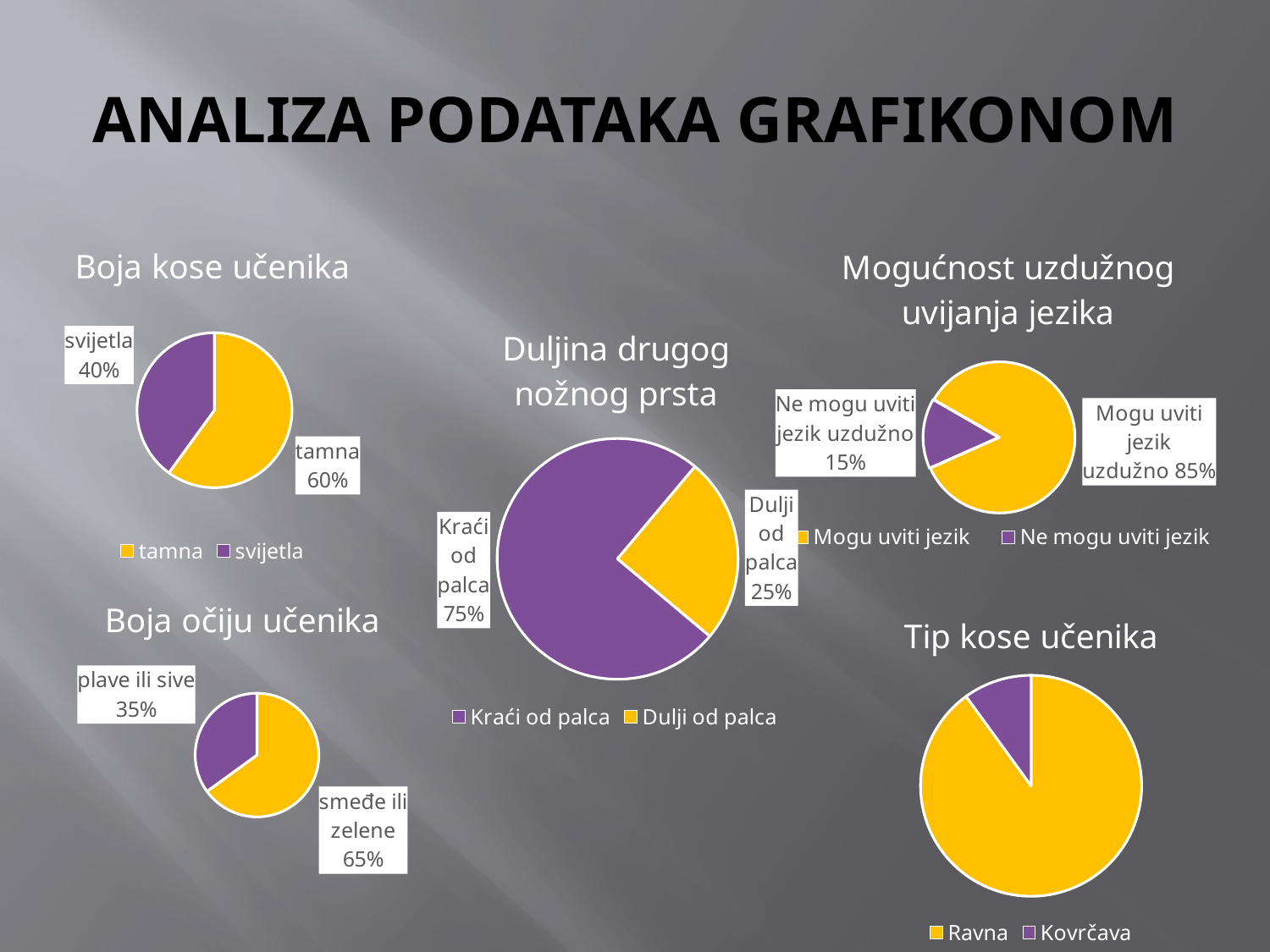
In the 'Mogućnost uzdužnog uvijanja jezika' chart, which category is the smallest? Ne mogu uviti jezik uzdužno In the 'Mogućnost uzdužnog uvijanja jezika' chart, what share of the pie is 'Mogu uviti jezik uzdužno'? 85% In the 'Duljina drugog nožnog prsta' chart, what is the value for 'Dulji od palca'? 25% How many charts are shown on the slide? 5 In the 'Tip kose učenika' chart, which is larger, 'Ravna' or 'Kovrčava'? Ravna In the 'Boja kose učenika' chart, what share of the pie is 'svijetla'? 40% What kind of chart is 'Boja kose učenika'? Pie chart In the 'Boja očiju učenika' chart, what is the difference between 'smeđe ili zelene' and 'plave ili sive'? 30% In the 'Boja očiju učenika' chart, what is the value for 'smeđe ili zelene'? 65% In the 'Duljina drugog nožnog prsta' chart, which category is the largest? Kraći od palca In the 'Boja kose učenika' chart, what share of the pie is 'tamna'? 60% How many entries does the legend of the 'Tip kose učenika' chart list? 2